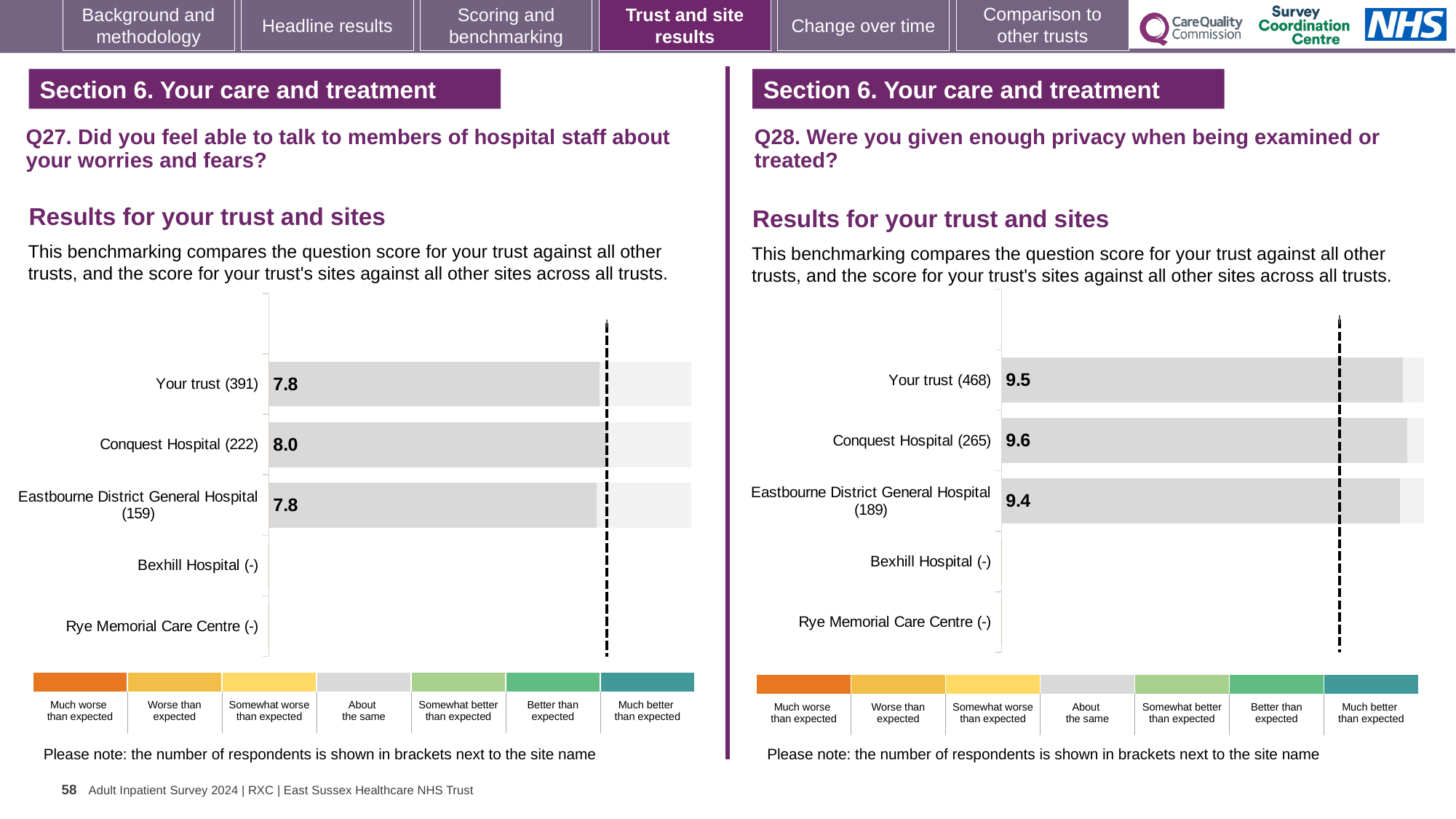
How many site categories are listed on the Q27 chart (left), including those with no score? 5 On the Q27 chart (left), which site has the highest score? Conquest Hospital (222) On the Q27 chart (left), what is the difference between the scores for Conquest Hospital and Eastbourne District General Hospital? 0.2 On the Q28 chart (right), which is larger: the score for Conquest Hospital or the score for Your trust? Conquest Hospital On the Q28 chart (right), what is the score for Your trust (468)? 9.5 On the Q28 chart (right), which site has the lowest score among those with a plotted bar? Eastbourne District General Hospital (189) What type of chart is used on the Q28 chart (right)? Bar chart On the Q27 chart (left), what is the score for Conquest Hospital (222)? 8.0 On the Q28 chart (right), what is the difference between the scores for Conquest Hospital and Eastbourne District General Hospital? 0.2 On the Q27 chart (left), what is the score for Your trust (391)? 7.8 On the Q27 chart (left), how many respondents are shown for Eastbourne District General Hospital? 159 On the Q28 chart (right), what is the score for Eastbourne District General Hospital (189)? 9.4